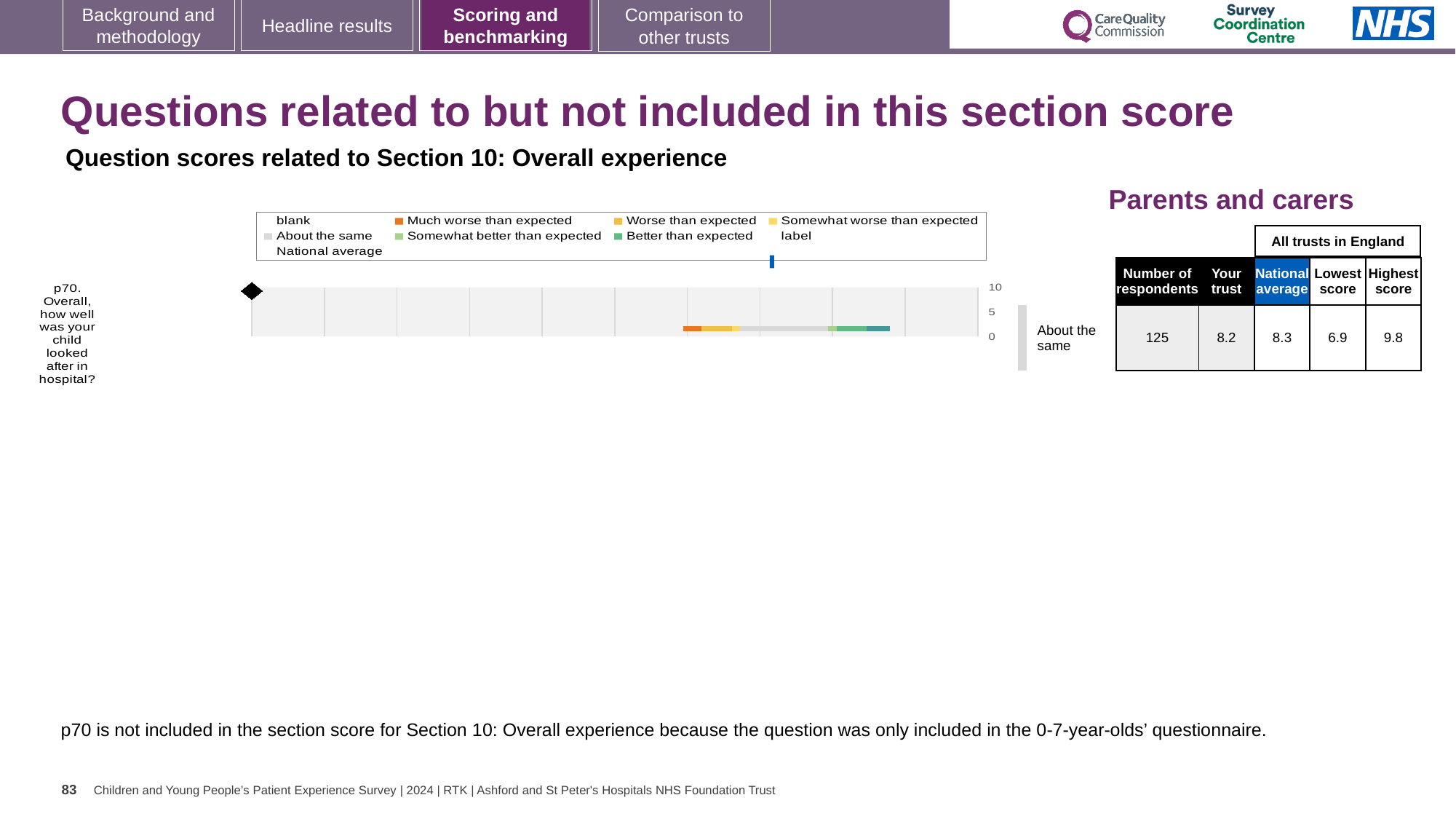
What benchmarking category is shown for p70 to the right of the bar? About the same How many entries does the chart legend list? 9 What kind of chart is used to show the benchmarking result for p70? bar chart In the Parents and carers table, what is the 'Your trust' score for p70? 8.2 How many questions are plotted in the chart? 1 Which question is plotted in the chart? p70. Overall, how well was your child looked after in hospital? In the Parents and carers table, what is the Lowest score among all trusts in England for p70? 6.9 In the Parents and carers table, how many respondents answered p70? 125 In the Parents and carers table, what is the difference between the Highest score and the Lowest score for p70? 2.9 In the Parents and carers table, what is the National average score for p70? 8.3 What is the highest value shown on the chart's vertical axis? 10 In the Parents and carers table, which is larger for p70: the Your trust score or the National average? National average